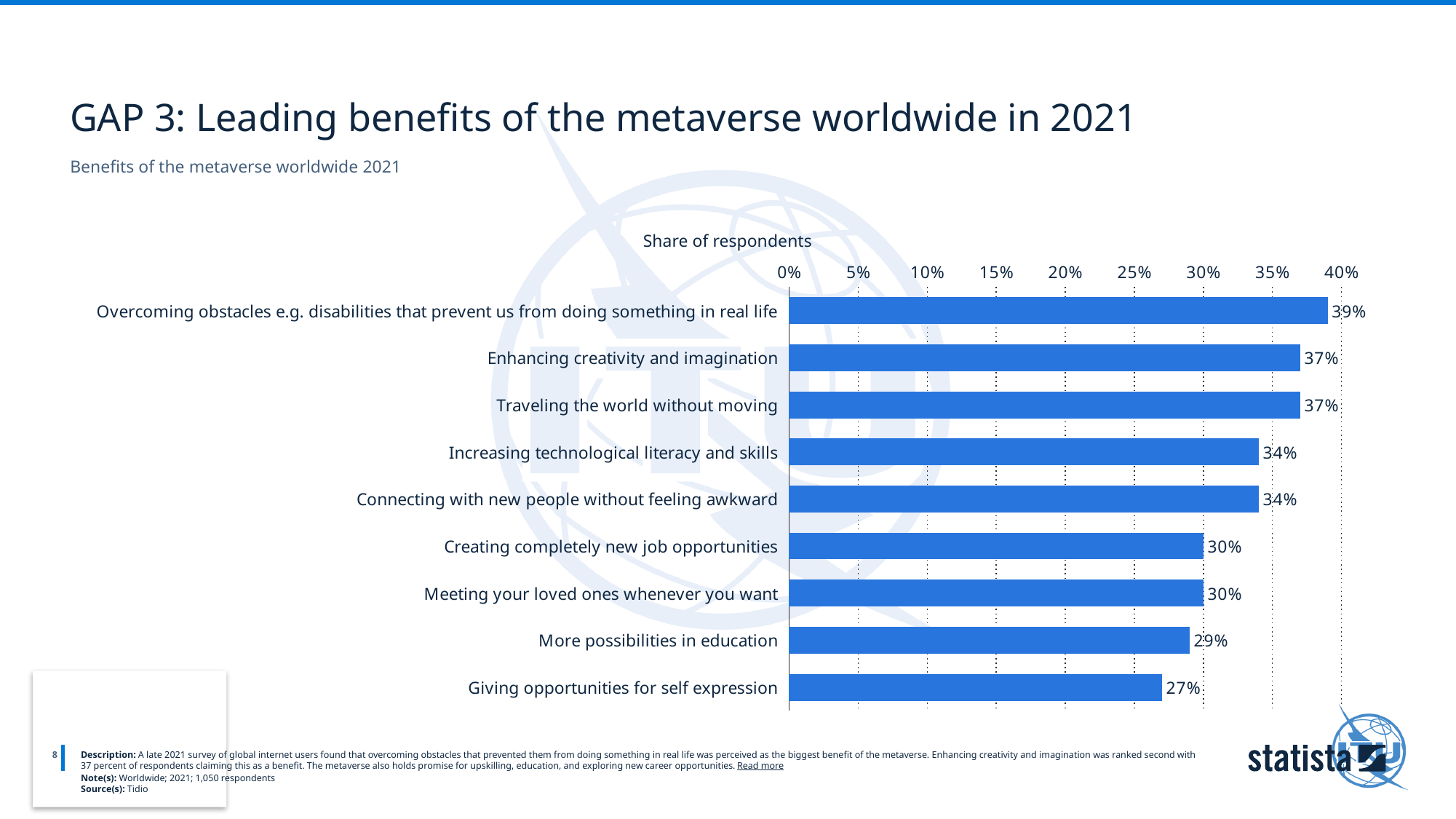
What is the difference in percentage points between 'Overcoming obstacles e.g. disabilities that prevent us from doing something in real life' and 'Giving opportunities for self expression'? 12 percentage points Is the value for 'Meeting your loved ones whenever you want' greater or less than 35%? less What share of respondents cited 'Overcoming obstacles e.g. disabilities that prevent us from doing something in real life' as a benefit of the metaverse? 39% What is the value for 'Giving opportunities for self expression'? 27% Which benefit has the lowest share of respondents? Giving opportunities for self expression Which benefit has the highest share of respondents? Overcoming obstacles e.g. disabilities that prevent us from doing something in real life Which has a larger share of respondents: 'Enhancing creativity and imagination' or 'Creating completely new job opportunities'? Enhancing creativity and imagination How many benefits are listed in the chart? 9 What type of chart is shown on the slide? Bar chart What is the value for 'More possibilities in education'? 29% What is the value for 'Increasing technological literacy and skills'? 34% What is the label of the horizontal axis of the chart? Share of respondents